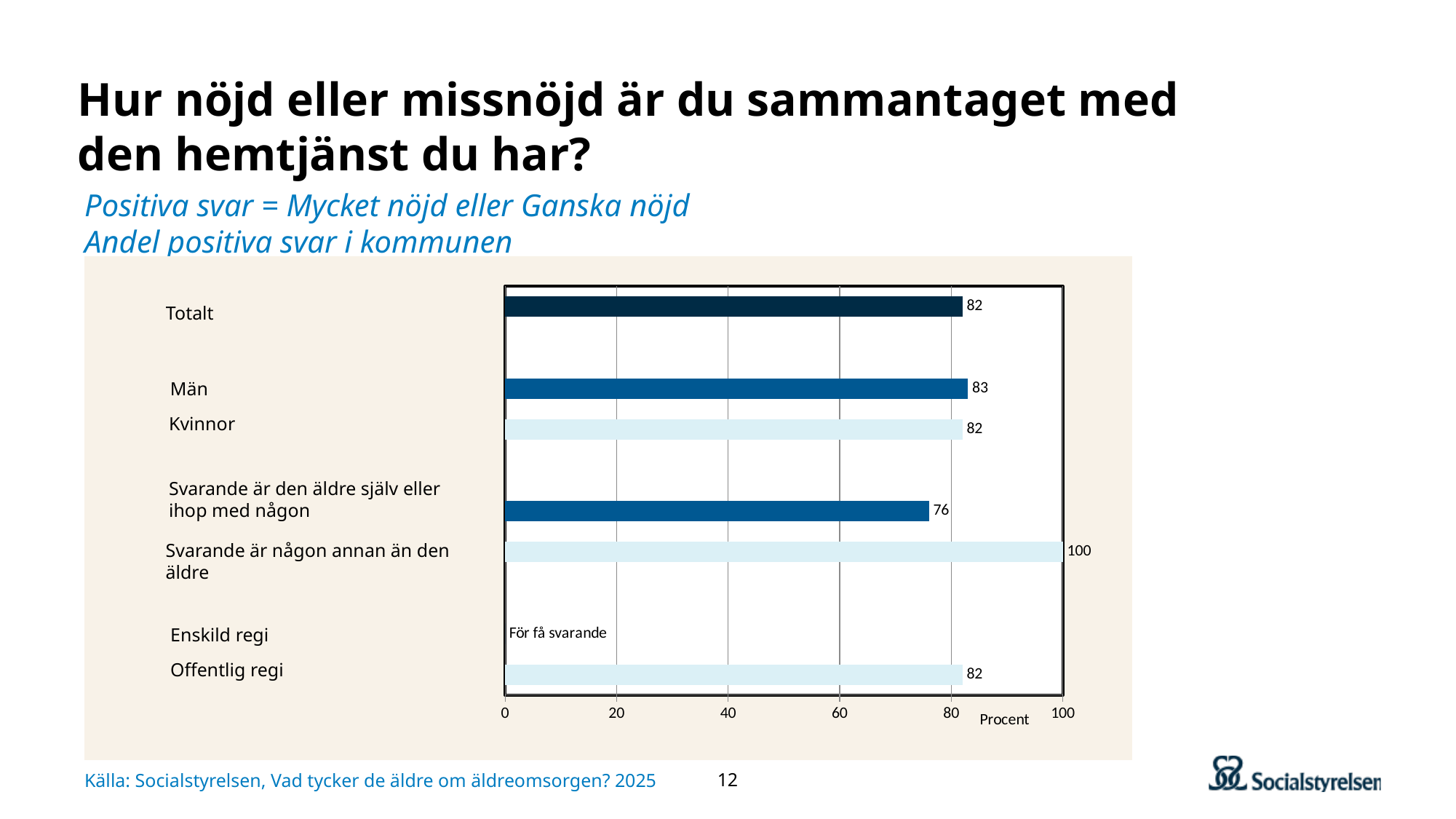
What is the value for Offentlig regi? 82 What is the value for Kvinnor? 82 What kind of chart is shown on the slide? Bar chart What is the difference between the values for 'Svarande är någon annan än den äldre' and 'Svarande är den äldre själv eller ihop med någon'? 24 What is the value for 'Svarande är den äldre själv eller ihop med någon'? 76 What is shown instead of a bar for Enskild regi? För få svarande What is the value for Män? 83 Which category with a plotted bar has the lowest value? Svarande är den äldre själv eller ihop med någon What is the value for 'Svarande är någon annan än den äldre'? 100 What unit label is shown on the x axis? Procent Which category has the highest value? Svarande är någon annan än den äldre What is the value for Totalt? 82